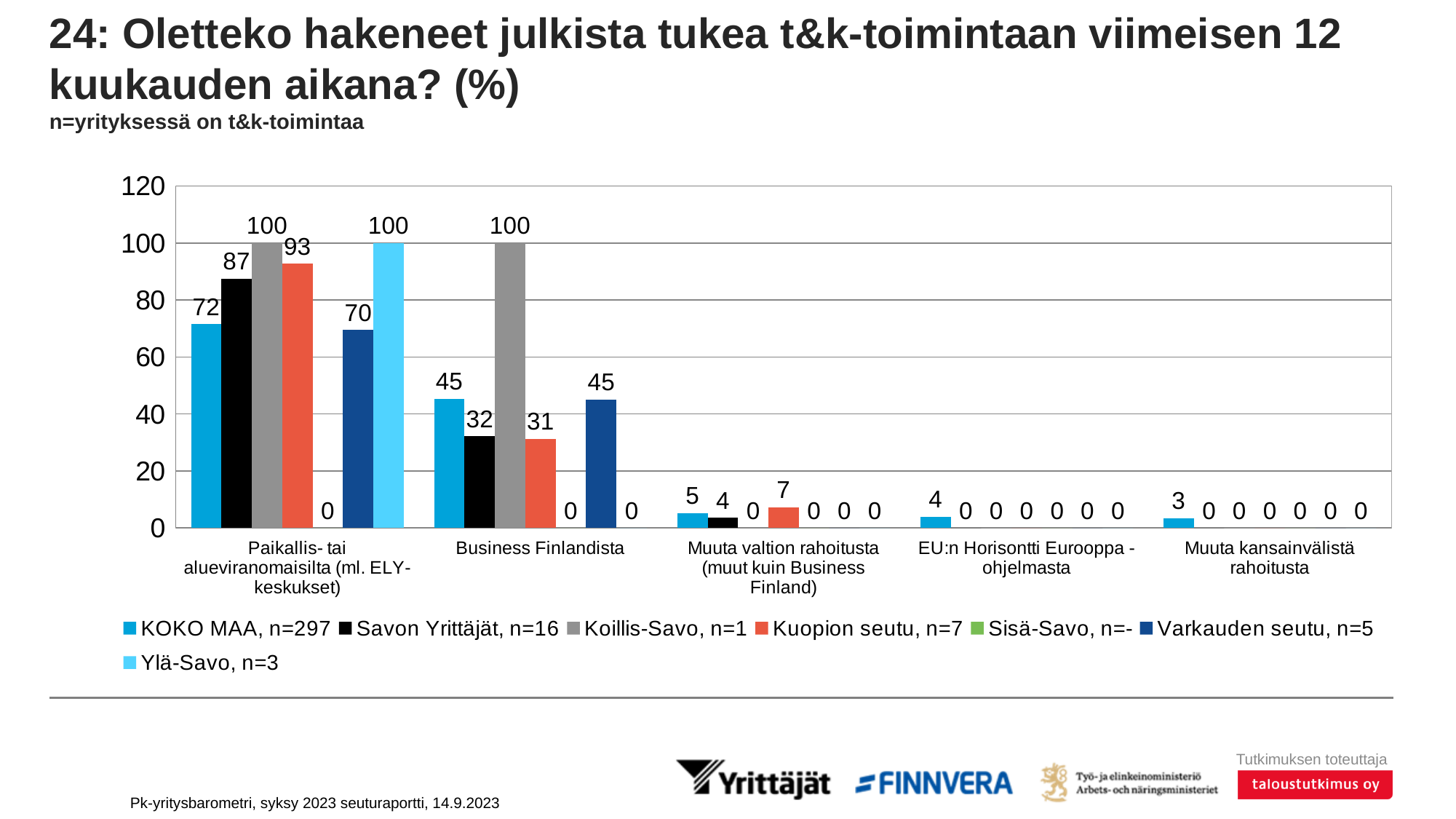
Which is larger in the category 'Business Finlandista': the value for Savon Yrittäjät or the value for Varkauden seutu? Varkauden seutu What is the value for KOKO MAA in the category 'Paikallis- tai alueviranomaisilta (ml. ELY-keskukset)'? 72 Which series has the lowest value in the category 'Paikallis- tai alueviranomaisilta (ml. ELY-keskukset)'? Sisä-Savo, n=- How many categories are shown on the x axis? 5 What kind of chart is shown on the slide? Bar chart What is the value for KOKO MAA in the category 'Muuta kansainvälistä rahoitusta'? 3 What is the difference between the Kuopion seutu and KOKO MAA values in the category 'Paikallis- tai alueviranomaisilta (ml. ELY-keskukset)'? 21 How many series does the legend list? 7 What is the sample size (n) shown in the legend for Savon Yrittäjät? 16 What is the value for Savon Yrittäjät in the category 'Business Finlandista'? 32 Which series has the highest value in the category 'Business Finlandista'? Koillis-Savo, n=1 What is the value for Kuopion seutu in the category 'Muuta valtion rahoitusta (muut kuin Business Finland)'? 7